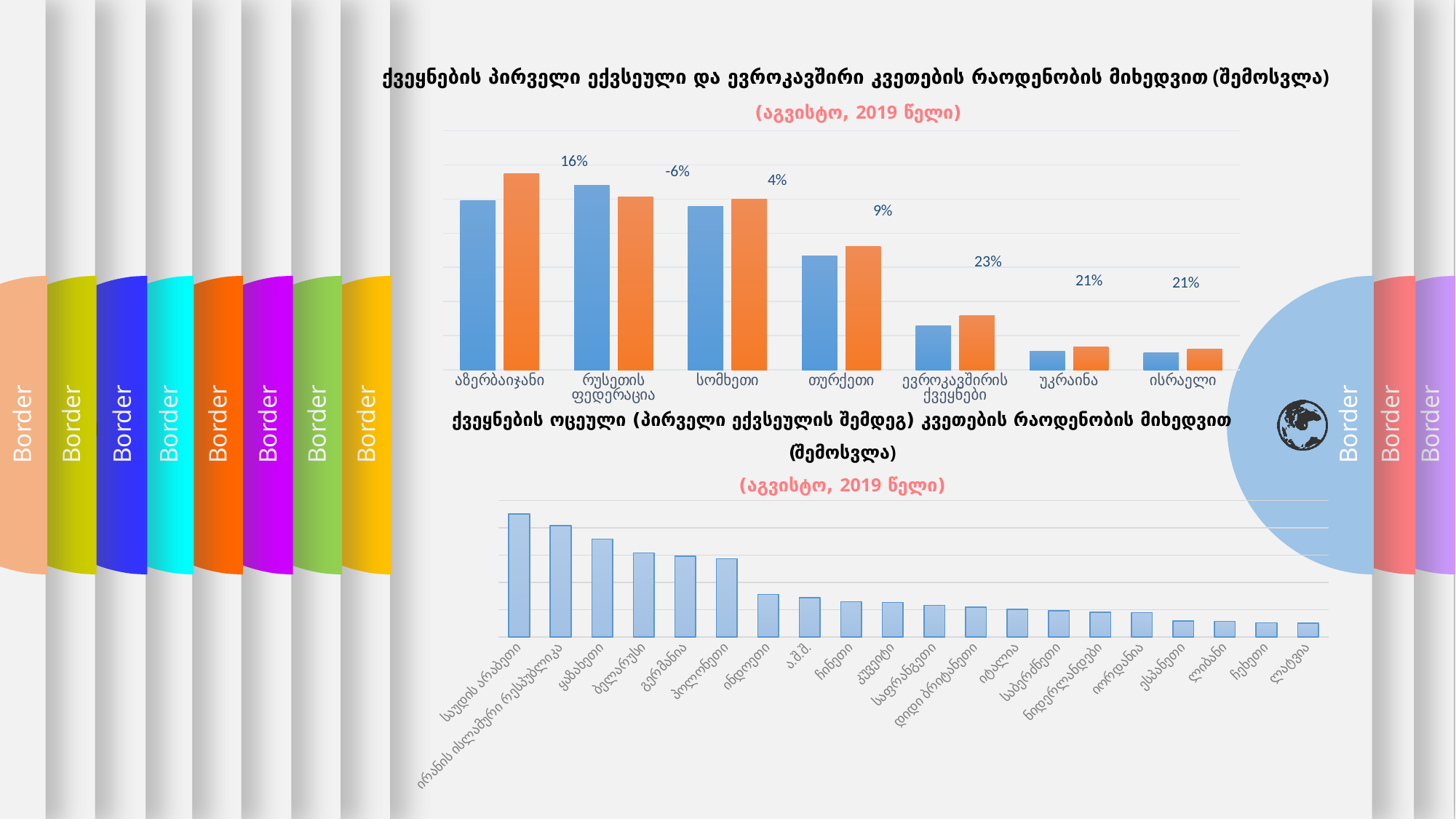
In the top chart, what is the difference in percentage points between the labels for ევროკავშირის ქვეყნები and აზერბაიჯანი? 7 In the top chart, which category has the highest percentage label? ევროკავშირის ქვეყნები What type of chart is the bottom chart? bar chart How many categories are shown on the x axis of the top chart? 7 In the top chart, which category has the lowest percentage label? რუსეთის ფედერაცია In the top chart, what percentage label is shown for რუსეთის ფედერაცია? -6% How many categories are shown on the x axis of the bottom chart? 20 In the top chart, what percentage label is shown for აზერბაიჯანი? 16% In the top chart, what percentage label is shown for ევროკავშირის ქვეყნები? 23% In the top chart, what percentage label is shown for თურქეთი? 9% In the top chart, which has the larger percentage label, სომხეთი or თურქეთი? თურქეთი In the bottom chart, which category has the tallest bar? საუდის არაბეთი